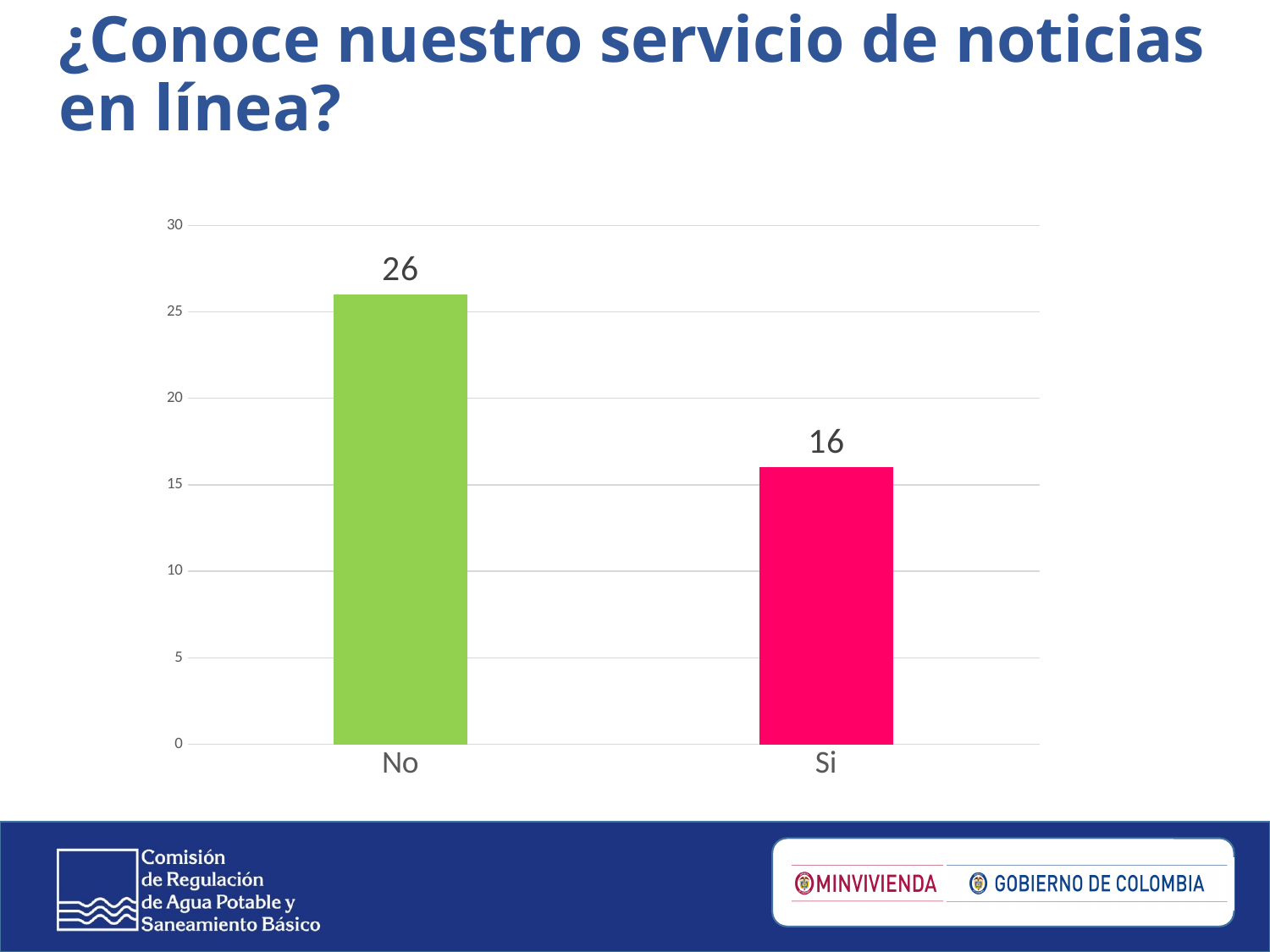
What kind of chart is shown on the slide? bar chart Which is larger, the value for "No" or the value for "Si"? No Which category has the lowest value? Si What colour is the bar for "Si"? pink Is the value for "Si" greater or less than 20? less What is the total of the two bars combined? 42 Is the value for "No" greater or less than 25? greater What is the difference between the values for "No" and "Si"? 10 Which category has the highest value? No What is the value for "No"? 26 How many categories are shown on the x axis? 2 What is the value for "Si"? 16